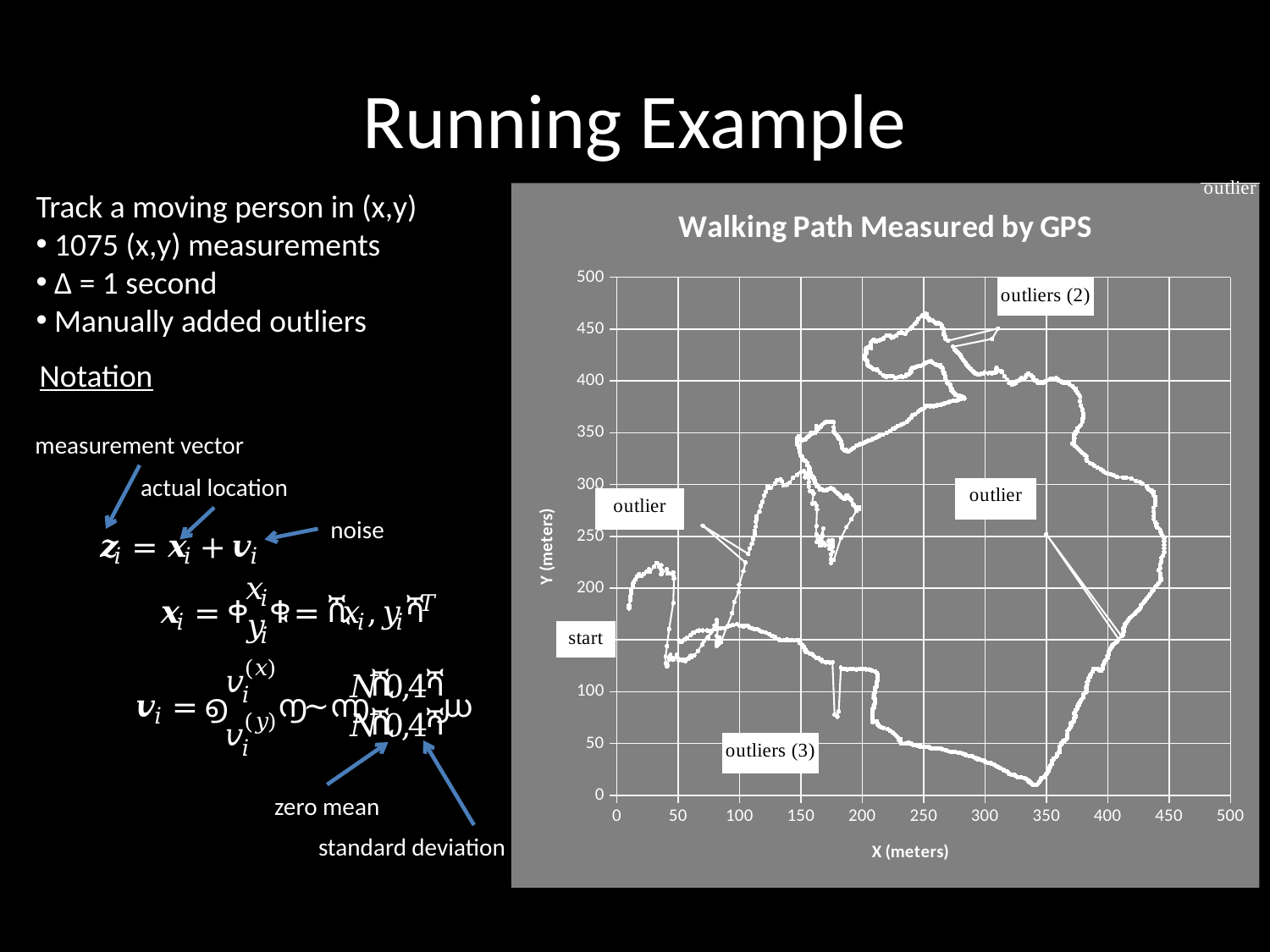
Is the largest X value reached by the walking path greater or less than 500? less What are the titles of the x axis and y axis of the chart? X (meters) and Y (meters) What kind of chart is shown on the slide? scatter chart Is the largest X value reached by the walking path greater or less than 400? greater Is the highest Y value reached by the walking path greater or less than 400? greater What is the title of the chart? Walking Path Measured by GPS